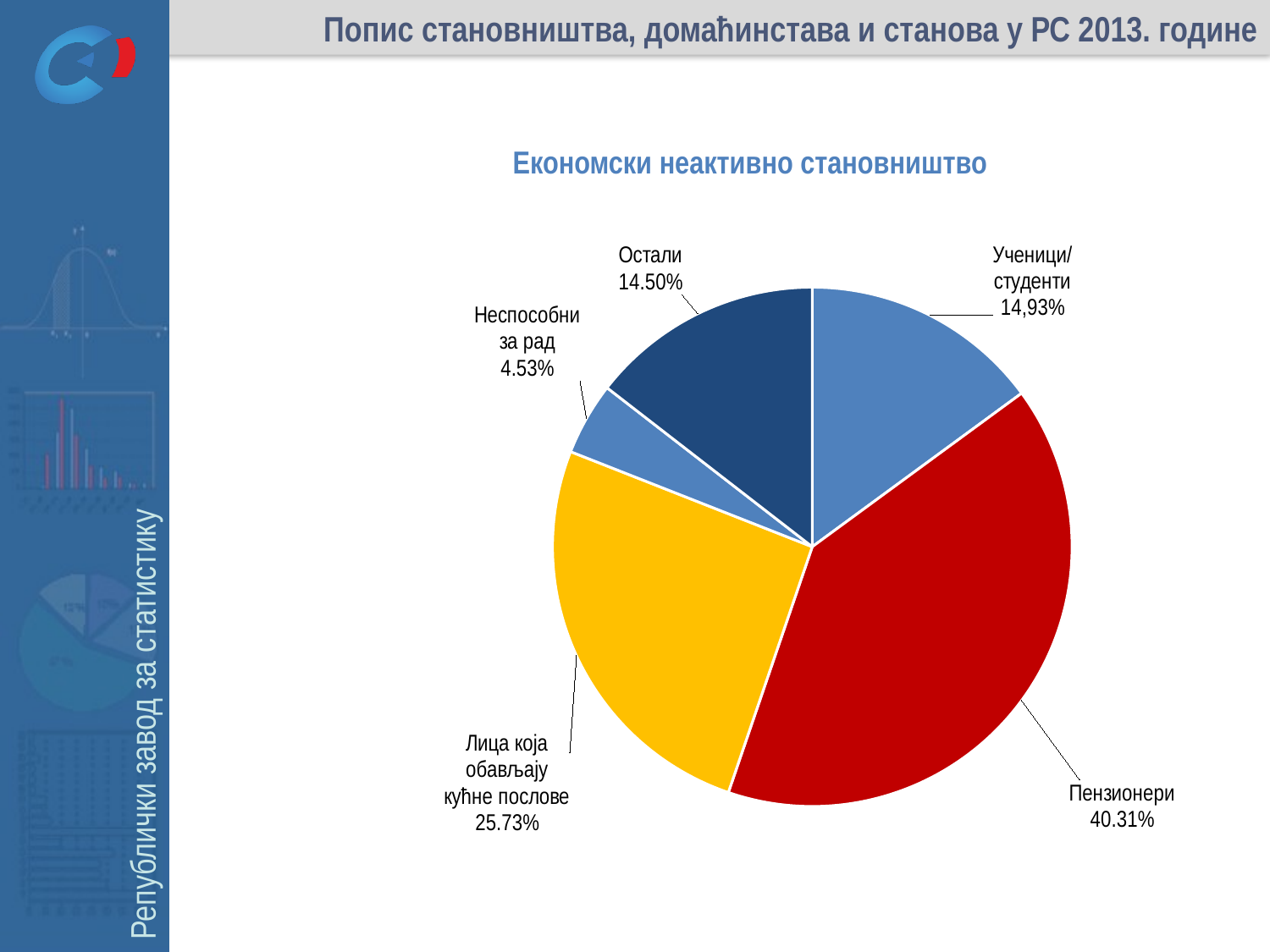
How many slices does the pie chart have? 5 What share of the pie is labelled for Лица која обављају кућне послове? 25.73% What is the difference in percentage points between the Пензионери slice and the Лица која обављају кућне послове slice? 14.58 What share of the pie is labelled for Неспособни за рад? 4.53% What is the title of the chart? Економски неактивно становништво What type of chart is shown on the slide? pie chart What share of the pie is labelled for Остали? 14.50% Which category has the smallest slice of the pie? Неспособни за рад Which is larger, the slice for Пензионери or the slice for Лица која обављају кућне послове? Пензионери What share of the pie is labelled for Пензионери? 40.31% Which category has the largest slice of the pie? Пензионери What share of the pie is labelled for Ученици/студенти? 14,93%